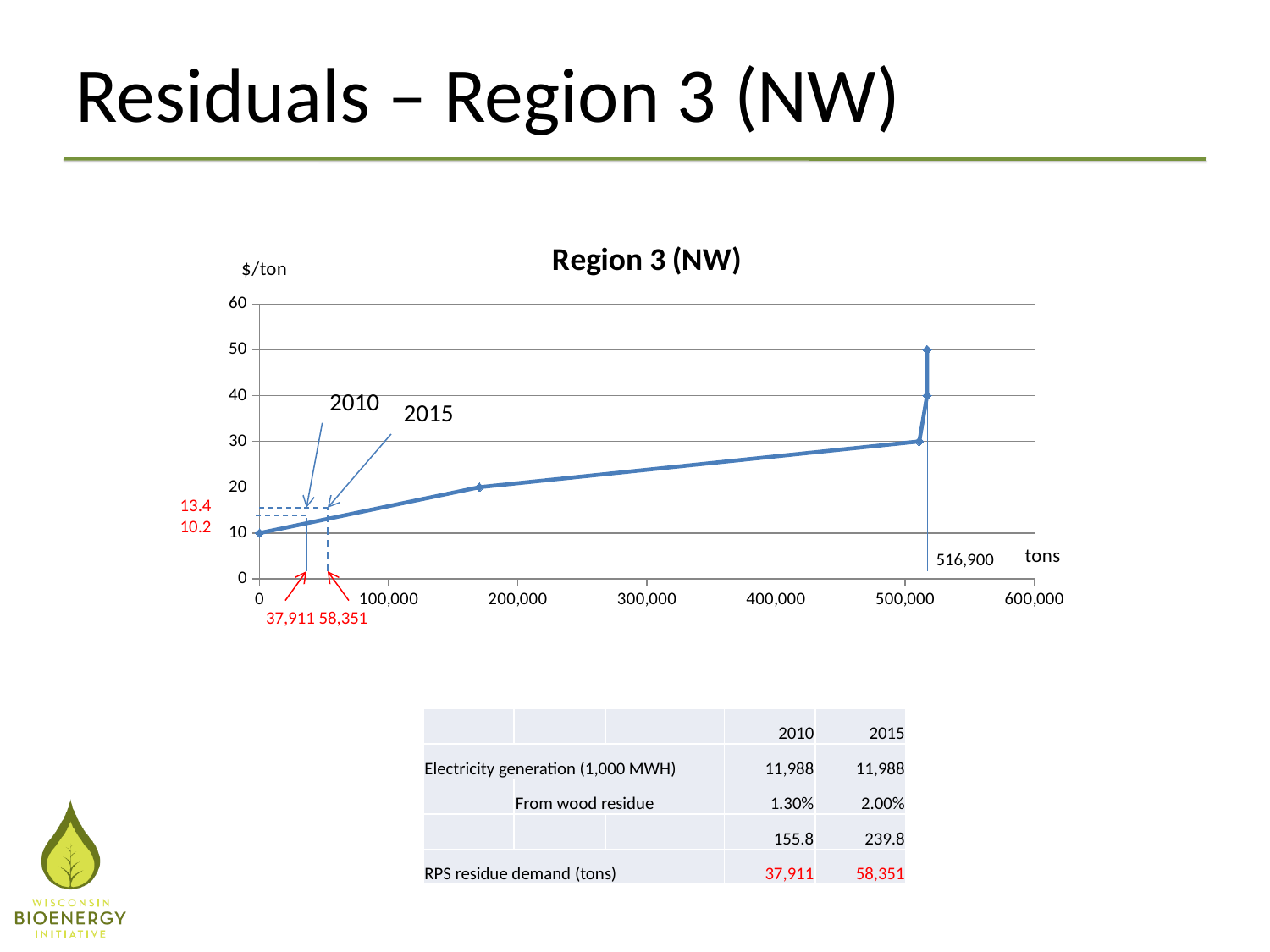
What $/ton price is annotated on the chart for 2010? 10.2 According to the chart annotation, what is the residue demand in tons for 2015? 58,351 According to the chart annotation, what is the residue demand in tons for 2010? 37,911 What kind of chart is shown on the slide? line chart Does the $/ton value rise or fall as tons increase along the x axis? rise Which year has the higher annotated $/ton price, 2010 or 2015? 2015 What is the difference in tons between the 2015 and 2010 annotated demand values? 20,440 What unit is shown on the y axis of the chart? $/ton What tons value is annotated at the vertical segment on the right of the curve? 516,900 What is the title of the chart? Region 3 (NW) What $/ton price is annotated on the chart for 2015? 13.4 What is the difference in $/ton between the 2015 and 2010 annotated prices? 3.2